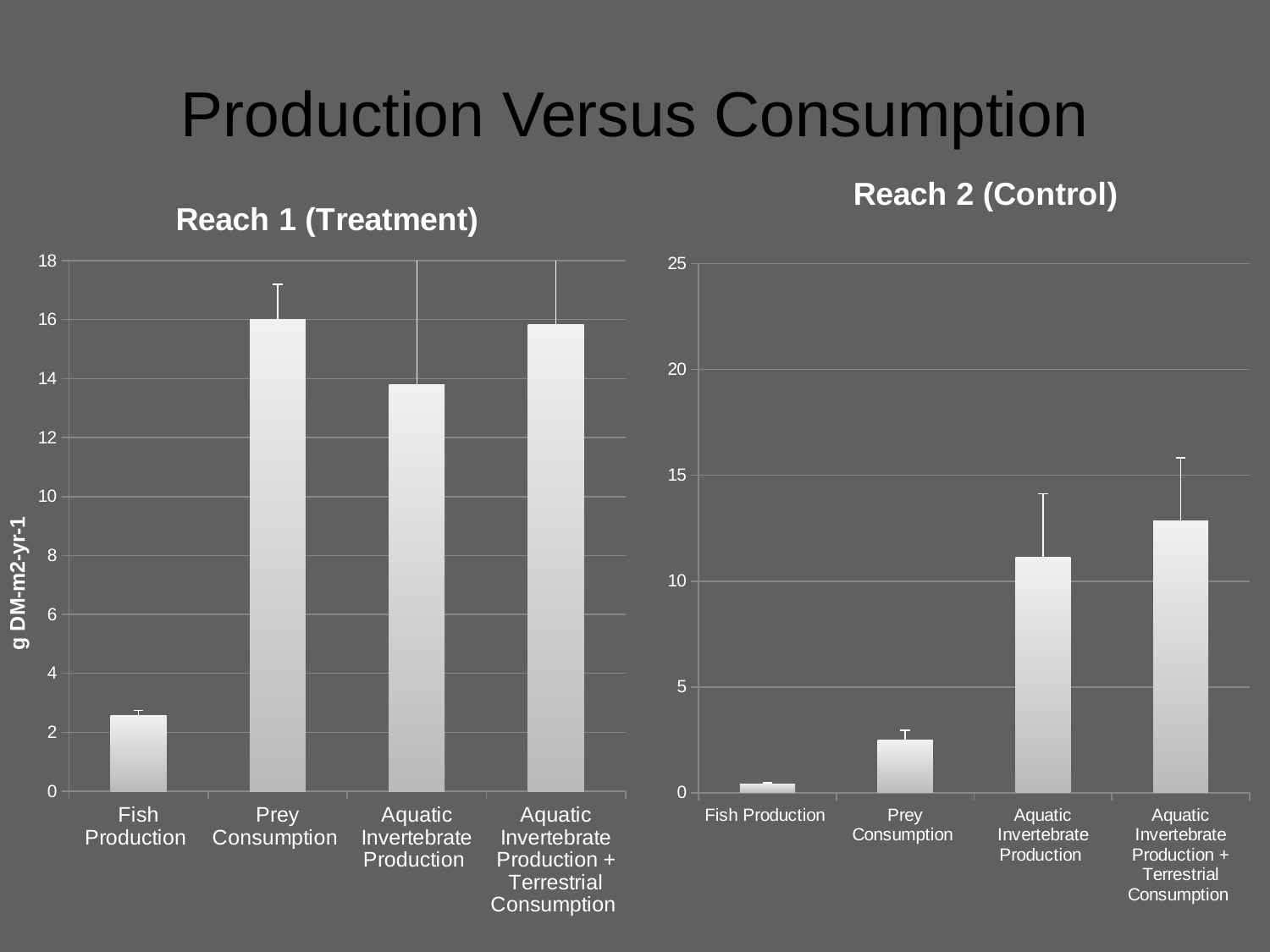
In the Reach 2 (Control) chart, which is larger: Prey Consumption or Aquatic Invertebrate Production? Aquatic Invertebrate Production In the Reach 1 (Treatment) chart, is the value for Fish Production greater or less than 4? less In the Reach 1 (Treatment) chart, is the value for Prey Consumption greater or less than 14? greater What is the y-axis label on the Reach 1 (Treatment) chart? g DM-m2-yr-1 In the Reach 2 (Control) chart, which category has the lowest value? Fish Production In the Reach 1 (Treatment) chart, which category has the lowest value? Fish Production In the Reach 2 (Control) chart, which category has the highest value? Aquatic Invertebrate Production + Terrestrial Consumption In the Reach 1 (Treatment) chart, which is larger: Prey Consumption or Fish Production? Prey Consumption What kind of chart is the Reach 1 (Treatment) chart? bar chart In the Reach 2 (Control) chart, is the value for Prey Consumption greater or less than 5? less How many categories are shown on the Reach 2 (Control) chart? 4